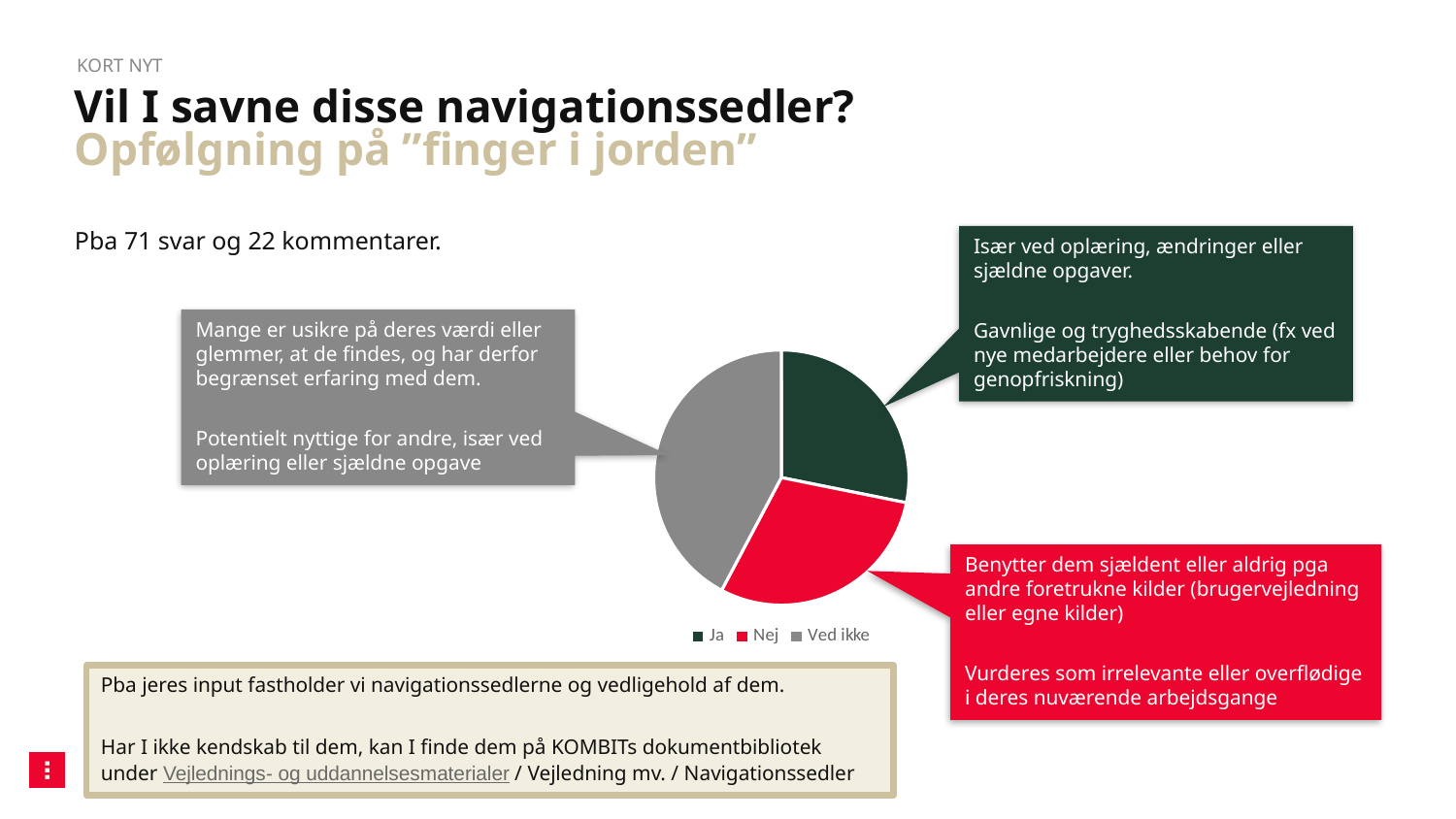
Which slice is larger in the pie chart, Ved ikke or Ja? Ved ikke Which legend entry is shown in grey in the pie chart? Ved ikke What kind of chart is shown on the slide? pie chart Which slice is larger in the pie chart, Ved ikke or Nej? Ved ikke How many slices does the pie chart have? 3 Which category has the largest slice in the pie chart? Ved ikke What colour is the Nej slice in the pie chart? red How many entries does the legend of the pie chart list? 3